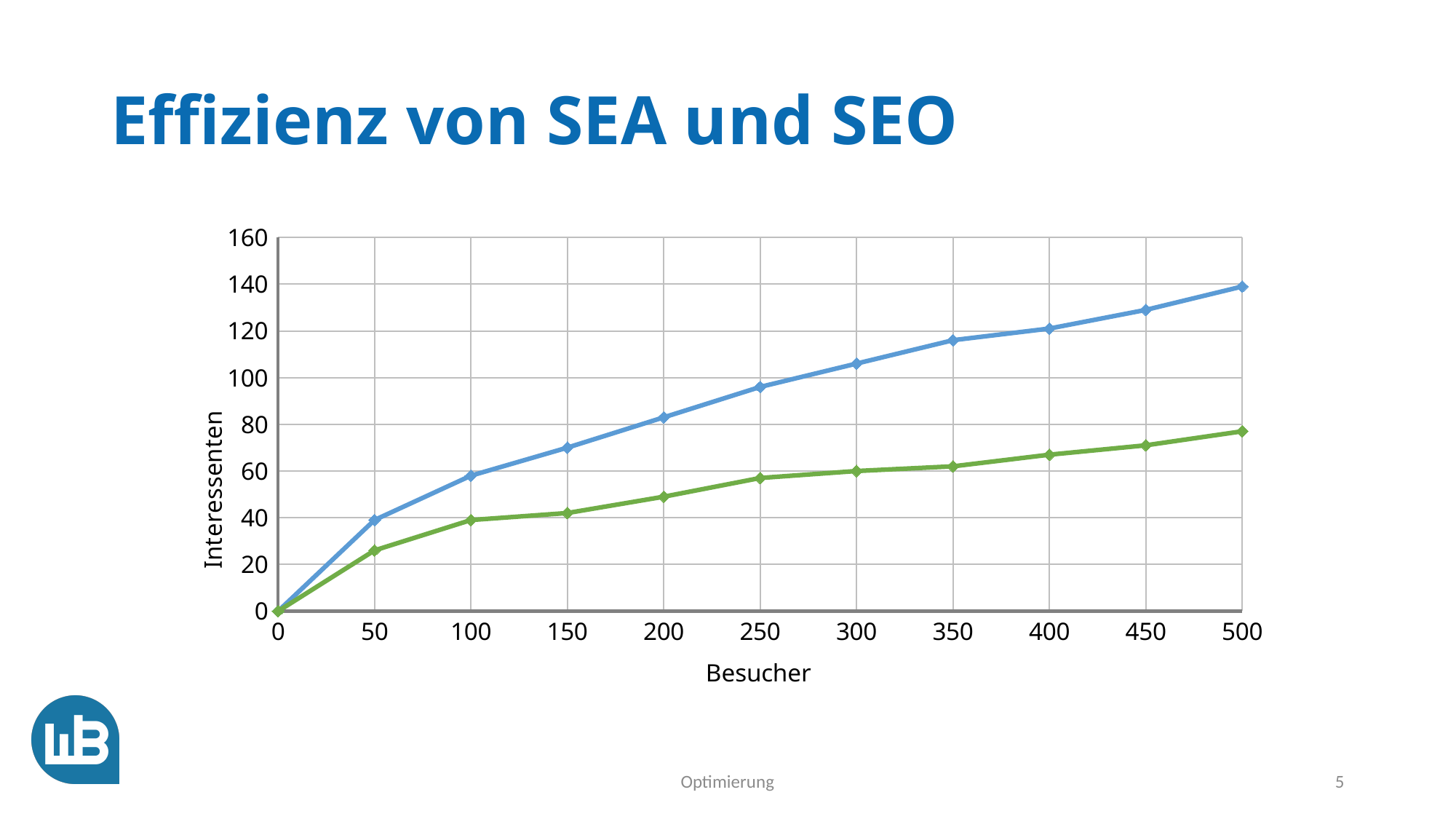
What kind of chart is shown on the slide? line chart What is the value of the blue line at 0 Besucher? 0 Does the blue line rise or fall as Besucher increases from 0 to 500? rise At which Besucher value does the blue line reach its highest point? 500 Is the value of the blue line at 100 Besucher greater or less than 40? greater How many data points are plotted along the x axis for each line? 11 Is the value of the blue line at 500 Besucher greater or less than 120? greater Is the value of the green line at 500 Besucher greater or less than 100? less What is the label of the y axis? Interessenten At 500 Besucher, which line has the larger value, the blue line or the green line? blue line